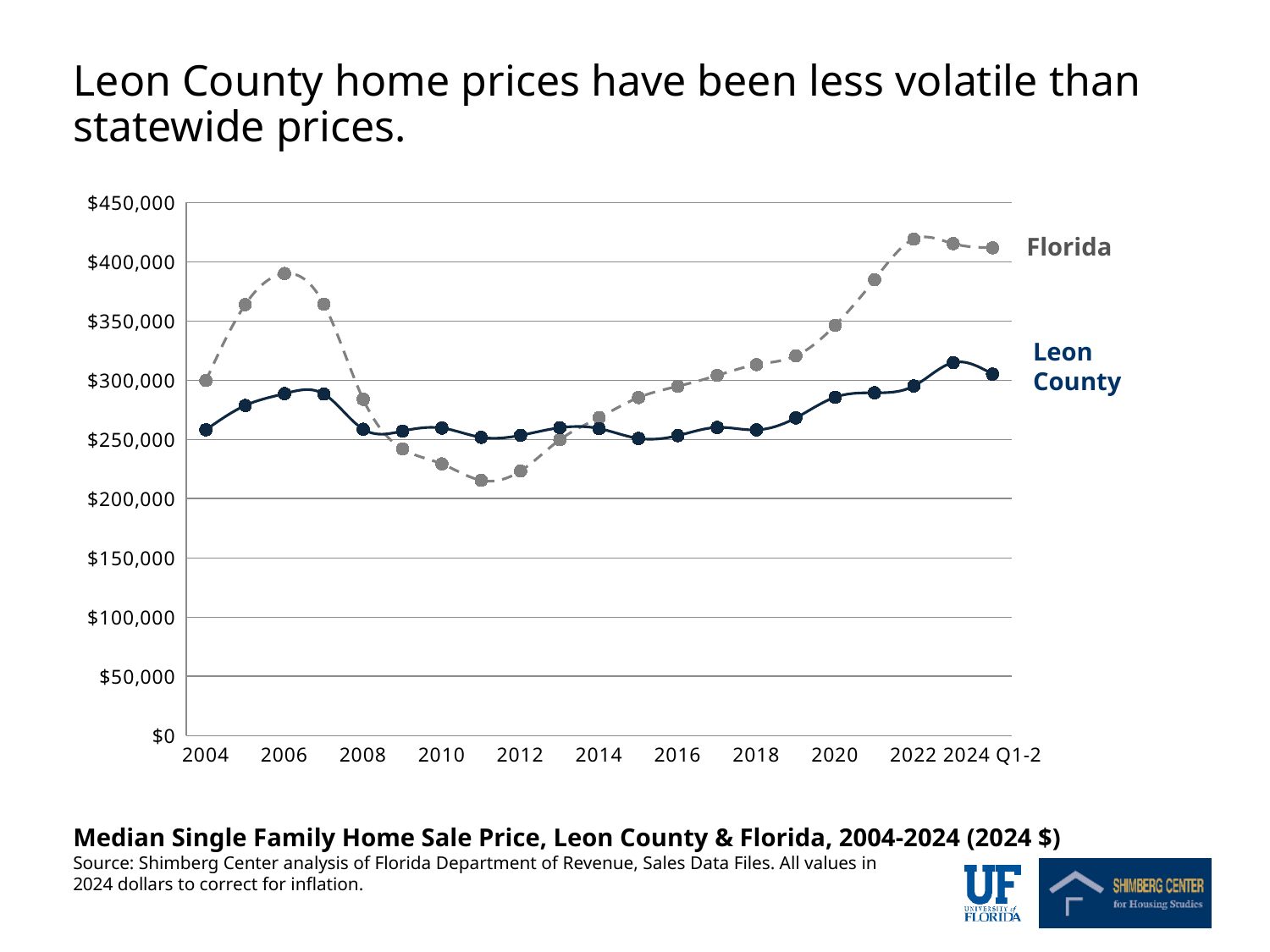
Is the Leon County value for 2023 greater or less than $300,000? greater What is the title of the chart? Median Single Family Home Sale Price, Leon County & Florida, 2004-2024 (2024 $) Is the Florida value for 2022 greater or less than $400,000? greater Is the Florida value for 2006 greater or less than $350,000? greater How many series does the chart show? 2 What kind of chart is shown on the slide? line chart Does the Florida series rise or fall between 2011 and 2022? rise In 2006, which series has the higher value, Florida or Leon County? Florida In 2011, which series has the higher value, Florida or Leon County? Leon County In which year does the Florida series reach its highest value? 2022 Which two series are plotted on the chart? Florida and Leon County